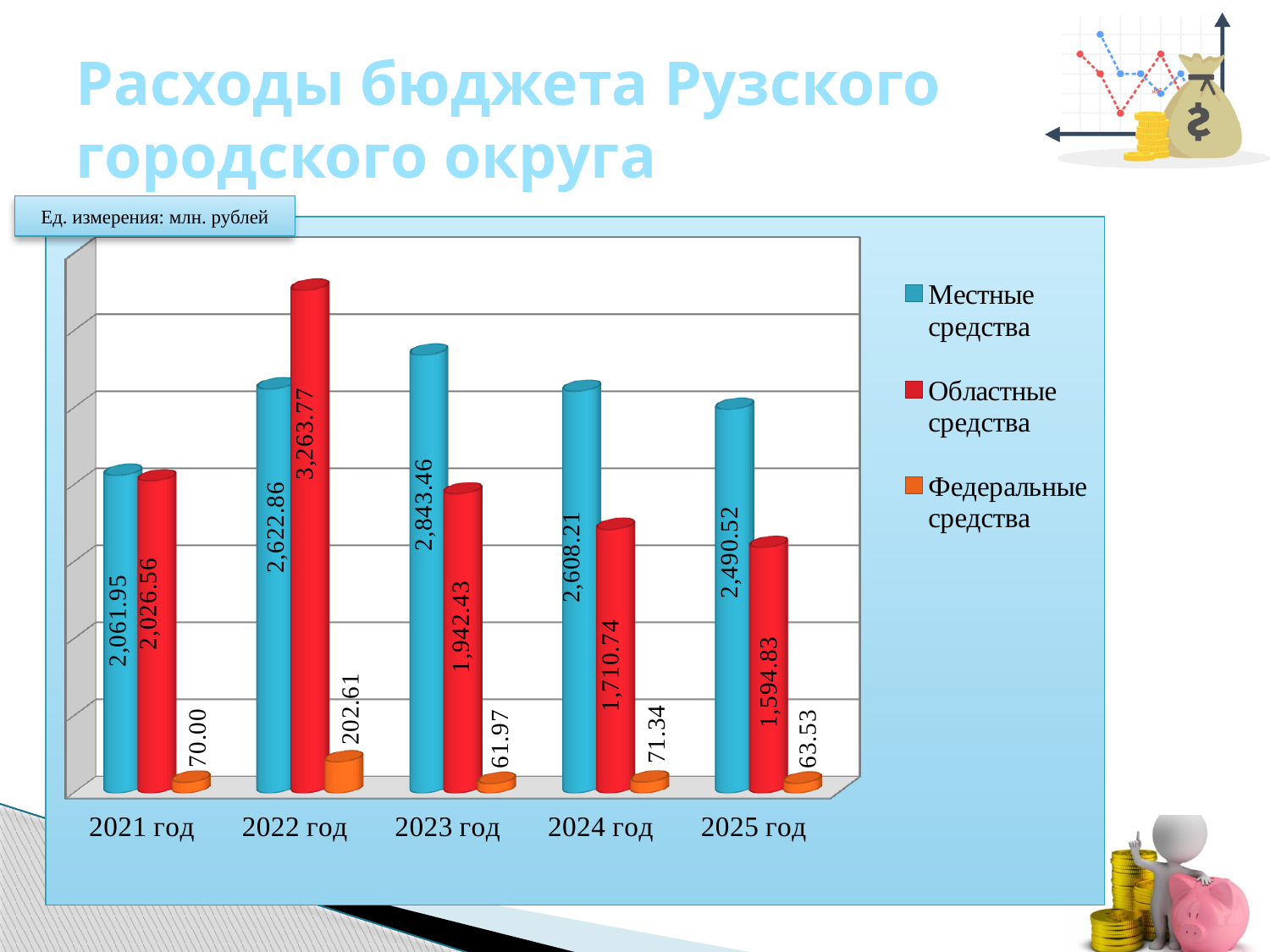
In which year is the value for Федеральные средства the lowest? 2023 год How many years are shown on the x axis? 5 What unit of measurement is stated for the chart? млн. рублей Do the values for Областные средства rise or fall from 2022 год to 2025 год? Fall What is the value for Федеральные средства in 2021 год? 70.00 How many series does the legend list? 3 What kind of chart is shown on the slide? Bar chart What is the value for Областные средства in 2022 год? 3,263.77 What is the value for Местные средства in 2023 год? 2,843.46 What is the difference between Областные средства and Местные средства in 2022 год? 640.91 In which year is the value for Областные средства the highest? 2022 год Which is larger in 2024 год: Местные средства or Областные средства? Местные средства